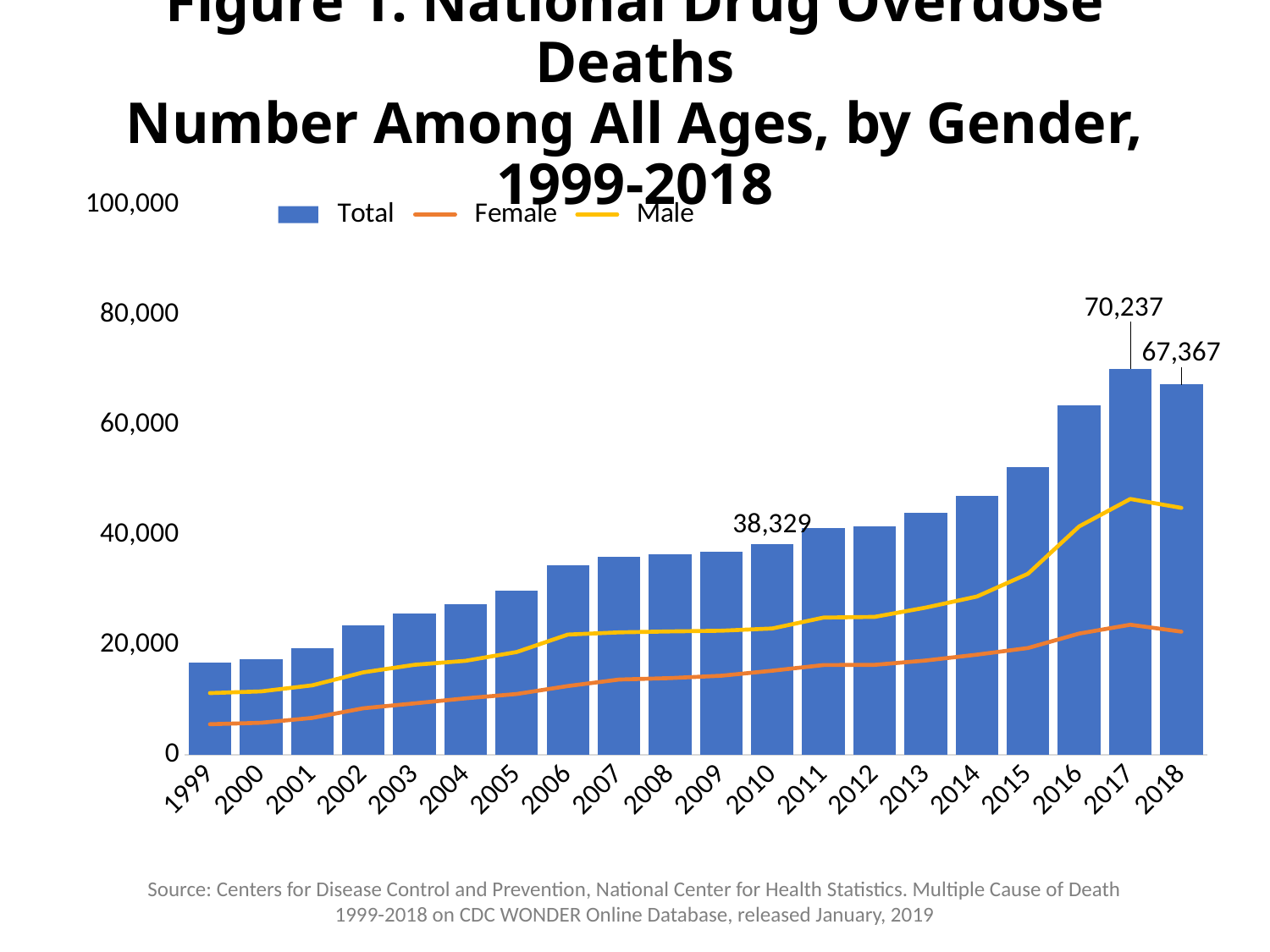
Which year has the lowest Total bar? 1999 What is the Total value for 2017? 70,237 How many series does the legend list? 3 How many years are shown on the x axis? 20 What is the difference between the Total values for 2017 and 2018? 2,870 What is the Total value for 2018? 67,367 Which series is plotted as bars rather than a line? Total What is the Total value for 2010? 38,329 Which year has the highest Total bar? 2017 Is the Female value for 2017 greater or less than 40,000? less Is the Male value for 2018 greater or less than 40,000? greater Is the Total value for 2016 greater or less than 60,000? greater